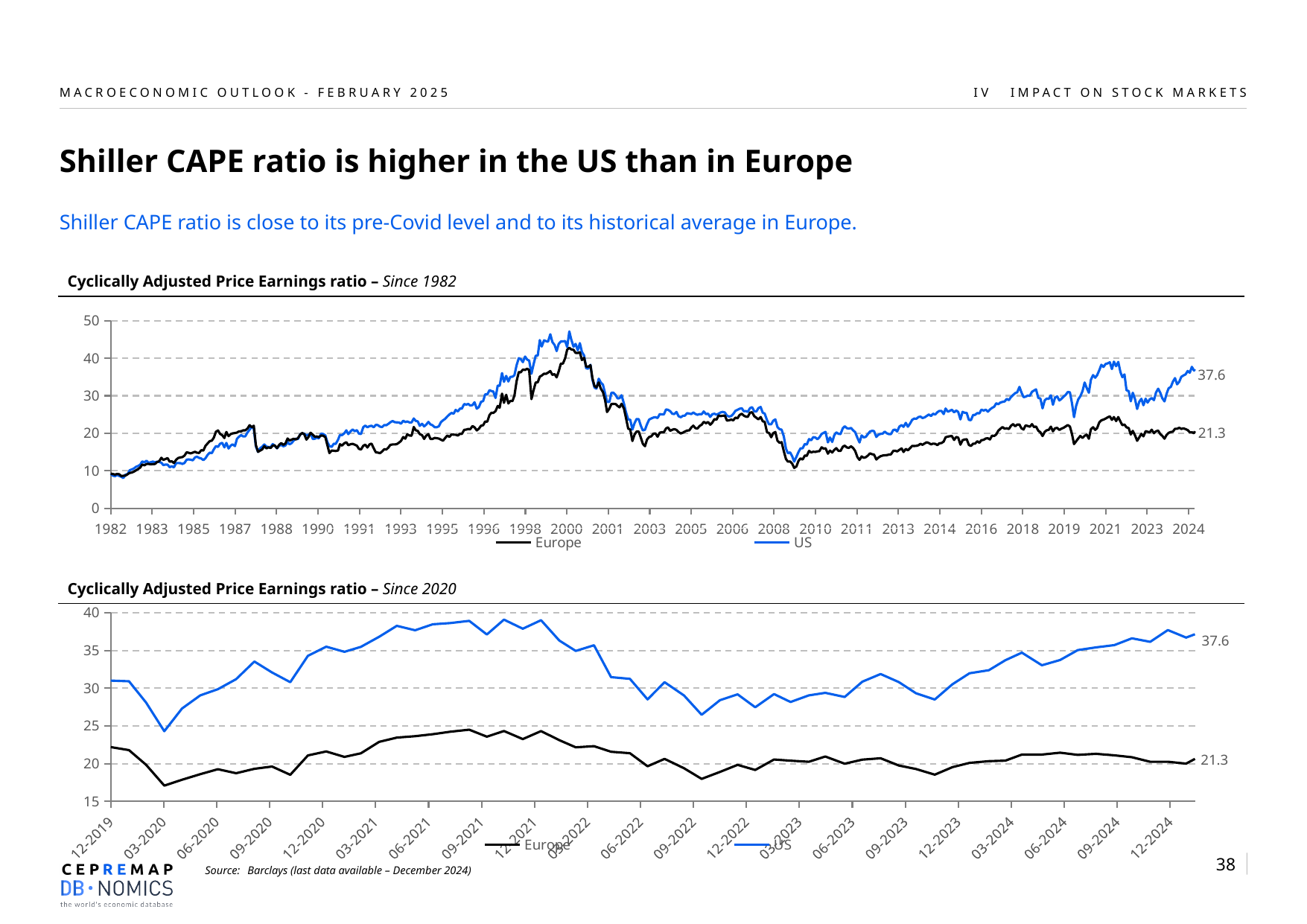
In the 'Since 1982' chart, is the US value around 2000 greater or less than 40? greater How many series does the legend of the 'Since 1982' chart list? 2 In the 'Since 1982' chart, what is the difference between the latest US value and the latest Europe value? 16.3 In the 'Since 2020' chart, which series ends higher, US or Europe? US In the 'Since 2020' chart, what is the latest value shown for the Europe series? 21.3 In the 'Since 1982' chart, what is the latest value shown for the US series? 37.6 Which colour is used for the Europe series in both charts? Black In the 'Since 2020' chart, does the US series rise or fall between 09-2022 and 12-2024? rise What kind of chart is the 'Since 2020' chart? Line chart In the 'Since 1982' chart, what is the latest value shown for the Europe series? 21.3 In the 'Since 2020' chart, is the Europe value at 09-2021 greater or less than 20? greater In the 'Since 2020' chart, is the US value at 03-2020 greater or less than 25? less